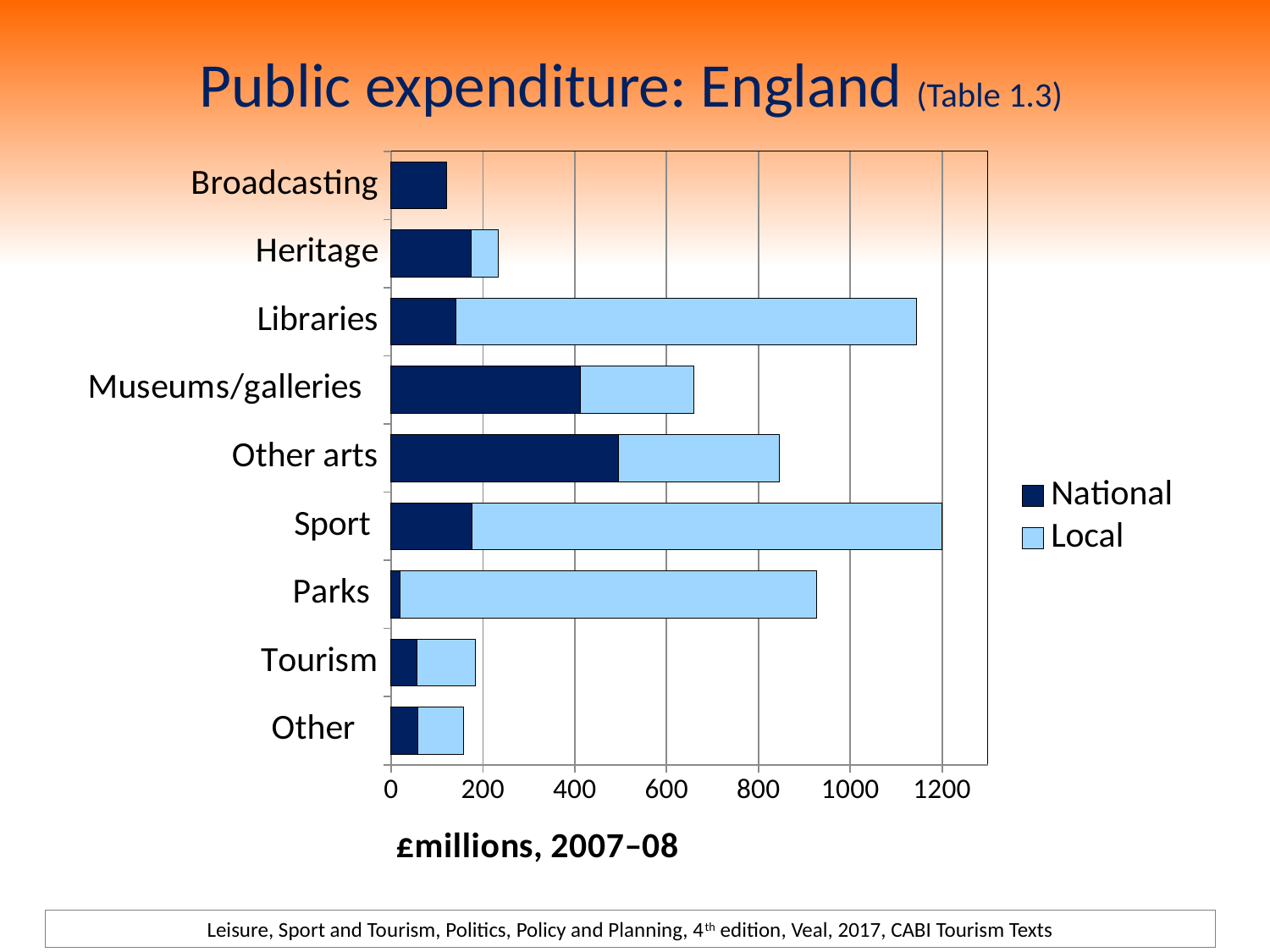
Is the total bar for Libraries greater or less than 1000? greater How many series does the legend list? 2 Which has the larger total bar, Museums/galleries or Tourism? Museums/galleries How many categories are plotted on the chart? 9 Is the value for Broadcasting greater or less than 200? less Which category has the largest National expenditure? Other arts Which category has the smallest National expenditure? Parks Is the National value for Other arts greater or less than 600? less What is the label on the horizontal axis of the chart? £millions, 2007–08 What kind of chart is shown on the slide? Stacked bar chart Which has the larger Local expenditure, Libraries or Heritage? Libraries